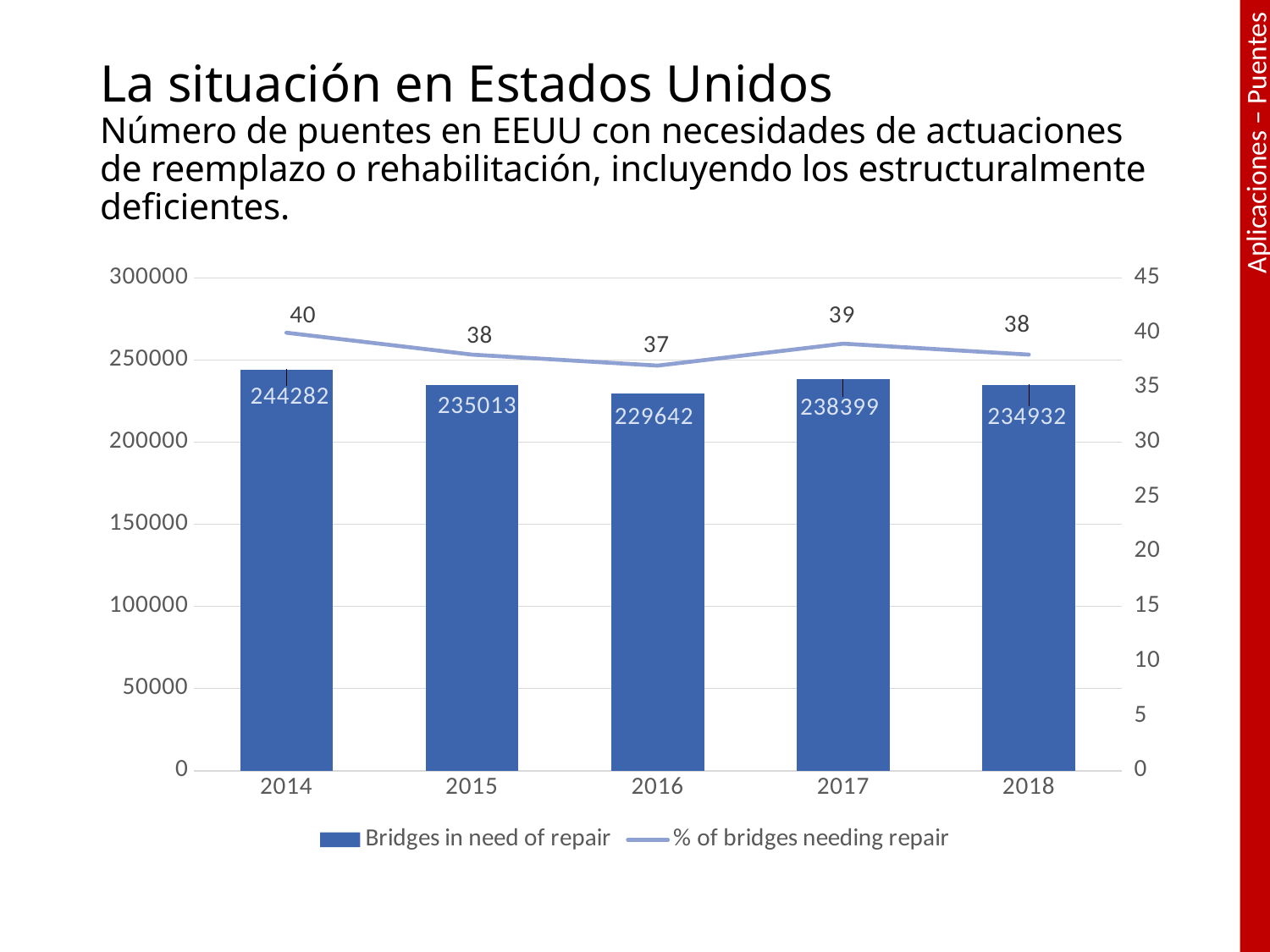
What is the difference in the number of bridges in need of repair between 2014 and 2016? 14640 Which year has the highest number of bridges in need of repair? 2014 What is the label of the line series in the legend? % of bridges needing repair What kind of chart is used for the 'Bridges in need of repair' series? bar chart How many bridges were in need of repair in 2014? 244282 How many series does the legend list? 2 How many years are shown on the x axis? 5 What percentage of bridges needed repair in 2016? 37 Which year has the lowest number of bridges in need of repair? 2016 What is the difference in the percentage of bridges needing repair between 2014 and 2016? 3 Does the number of bridges in need of repair rise or fall from 2014 to 2016? fall Which year has more bridges in need of repair, 2015 or 2017? 2017